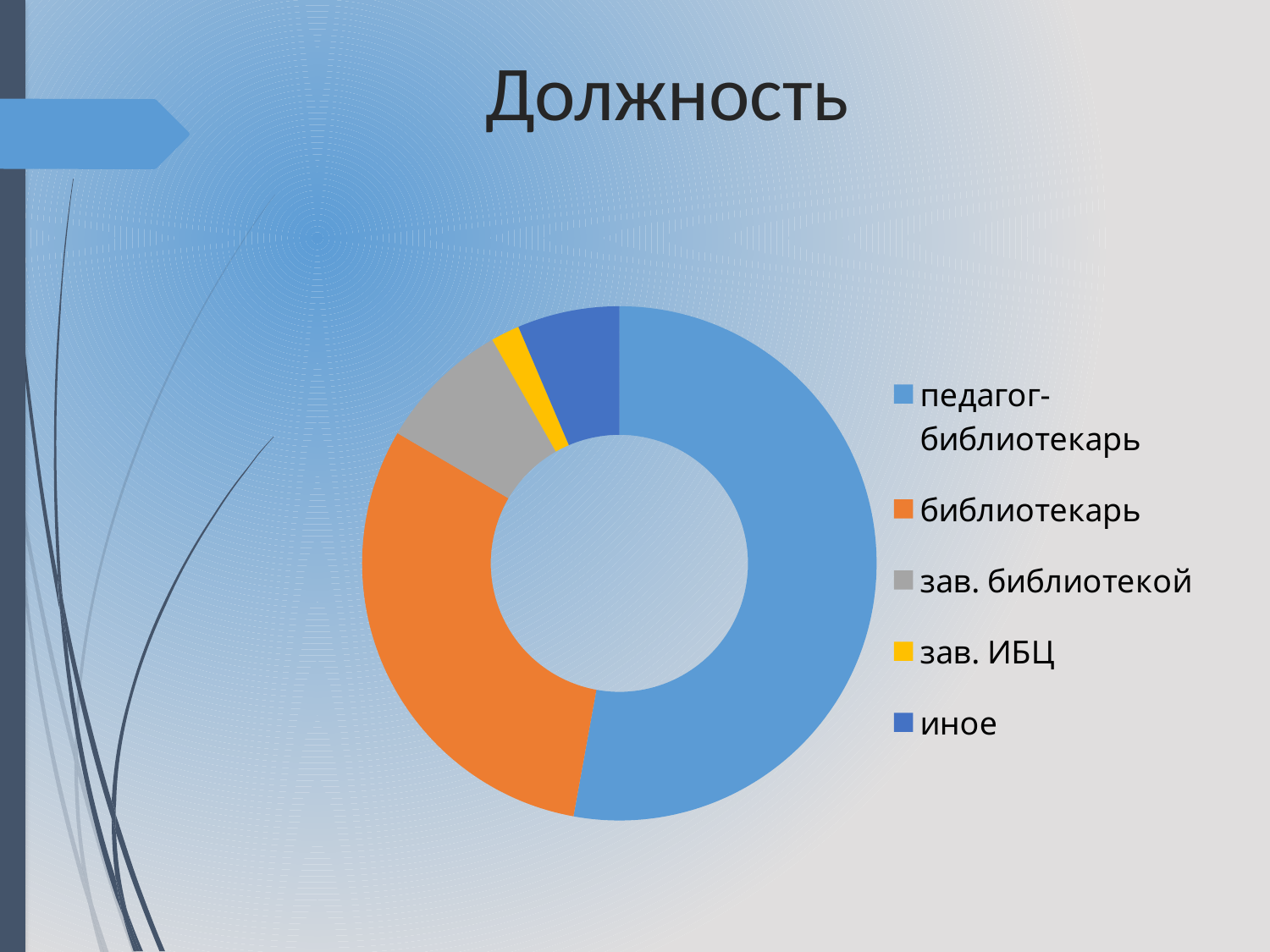
Which is larger, the share for библиотекарь or the share for зав. библиотекой? библиотекарь Which category has the largest share of the chart? педагог-библиотекарь Which is larger, the share for педагог-библиотекарь or the share for библиотекарь? педагог-библиотекарь What colour represents библиотекарь in the chart? orange How many categories does the chart show? 5 Which category has the smallest share of the chart? зав. ИБЦ Which category is shown in yellow? зав. ИБЦ What kind of chart is shown on the slide? doughnut chart Which is larger, the share for иное or the share for зав. ИБЦ? иное What is the title of the chart? Должность